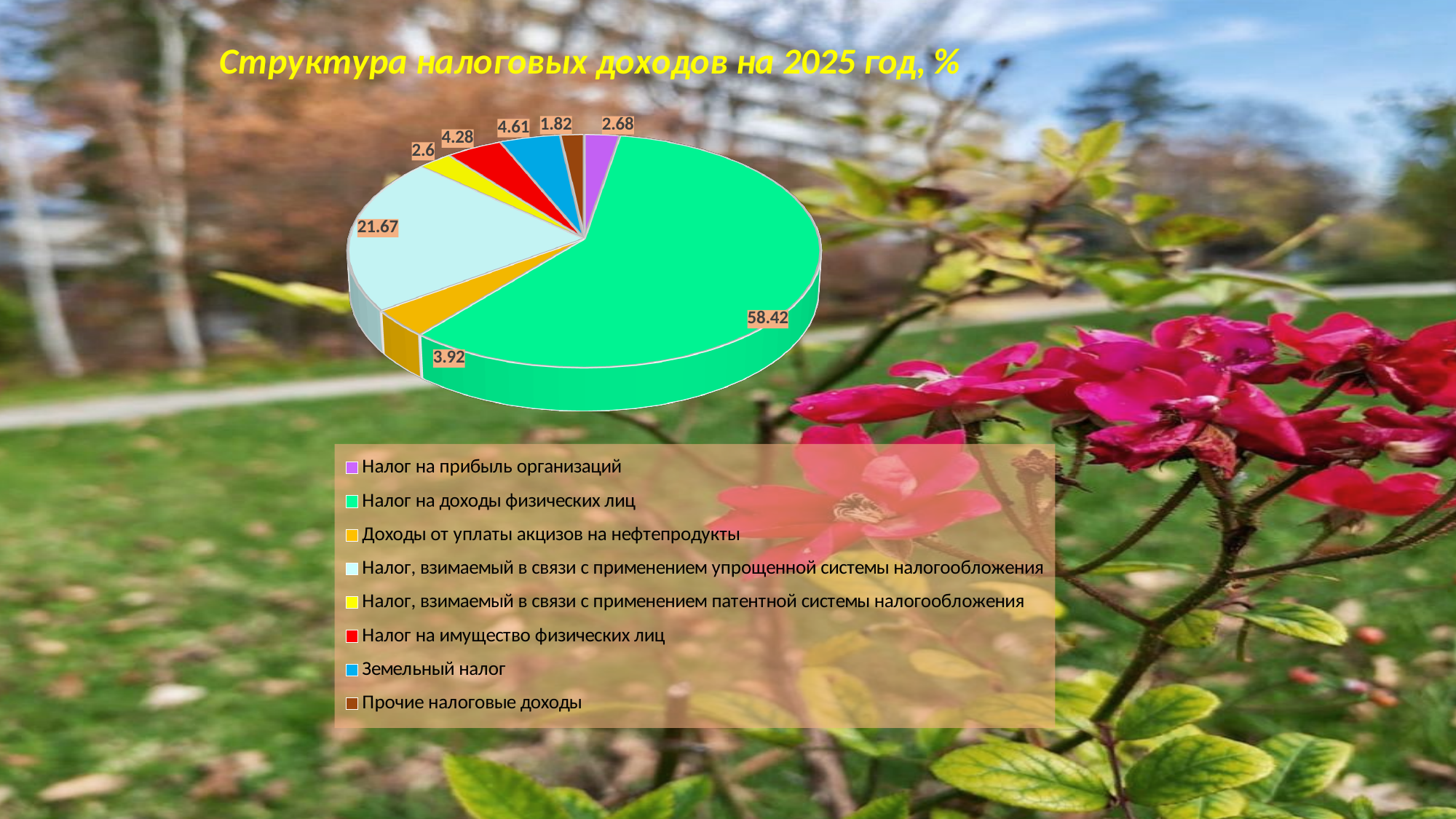
Which is larger: the value for Земельный налог or the value for Налог на имущество физических лиц? Земельный налог What type of chart is shown on the slide? Pie chart What is the value for Прочие налоговые доходы? 1.82 What is the title of the chart? Структура налоговых доходов на 2025 год, % Which category has the largest share of the pie? Налог на доходы физических лиц What is the value for Налог на доходы физических лиц? 58.42 What is the difference between the values for Налог на доходы физических лиц and Налог, взимаемый в связи с применением упрощенной системы налогообложения? 36.75 What is the value for Земельный налог? 4.61 What colour is the slice for Доходы от уплаты акцизов на нефтепродукты? Orange Which category has the smallest share of the pie? Прочие налоговые доходы What is the value for Налог, взимаемый в связи с применением упрощенной системы налогообложения? 21.67 How many categories does the pie chart have? 8